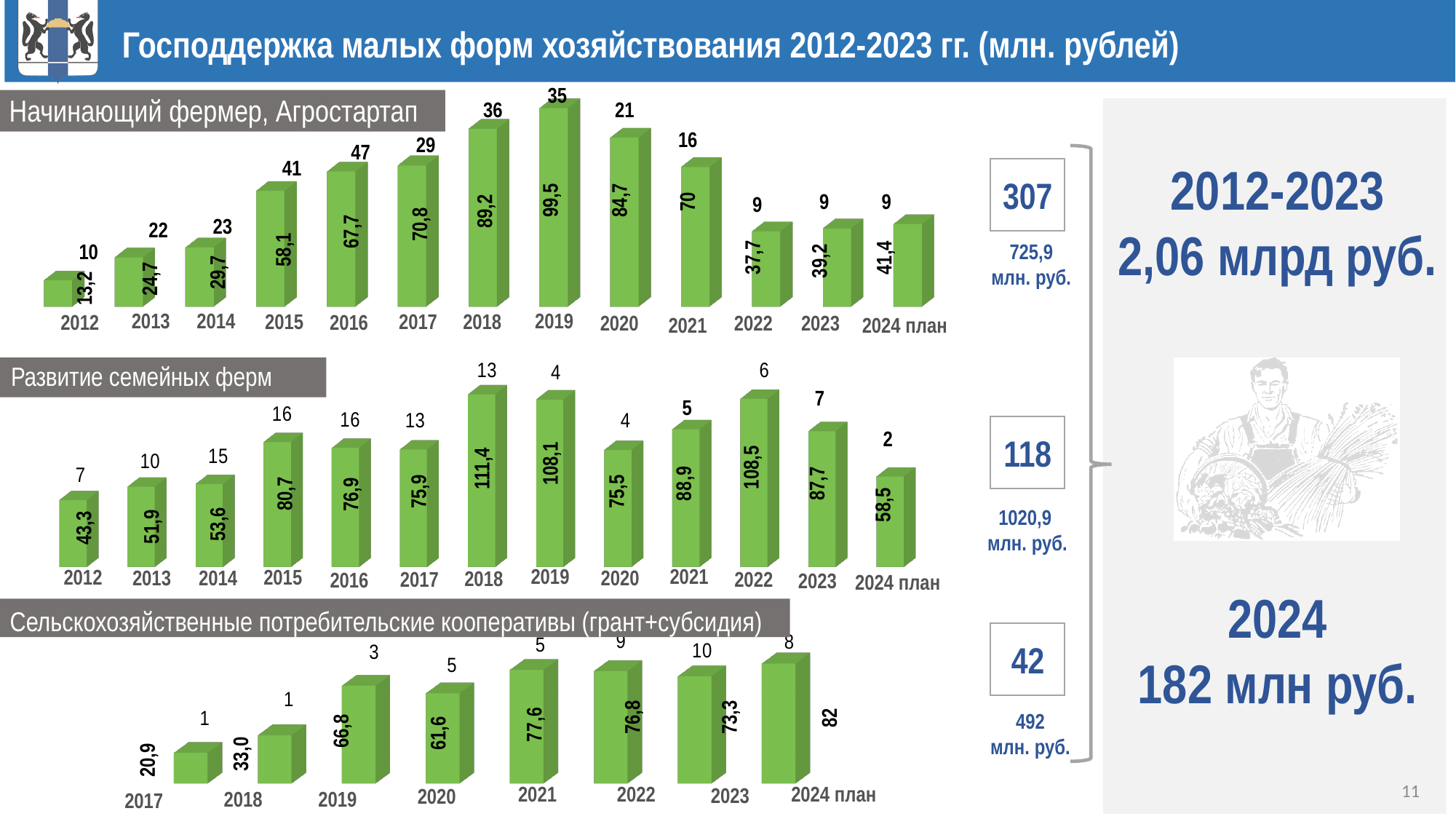
In the chart 'Развитие семейных ферм', what is the value for 2018? 111,4 In the chart 'Начинающий фермер, Агростартап', what is the value for 2019? 99,5 How many bars are in the chart 'Начинающий фермер, Агростартап'? 13 In the chart 'Развитие семейных ферм', what is the difference between the values for 2018 and 2012? 68,1 In the chart 'Сельскохозяйственные потребительские кооперативы (грант+субсидия)', what is the value for 2024 план? 82 In the chart 'Начинающий фермер, Агростартап', do the values rise or fall from 2012 to 2019? Rise What kind of chart is 'Развитие семейных ферм'? Bar chart In the chart 'Развитие семейных ферм', which year has the lowest value? 2012 In the chart 'Начинающий фермер, Агростартап', which year has the highest value? 2019 In the chart 'Сельскохозяйственные потребительские кооперативы (грант+субсидия)', which is larger, the value for 2021 or the value for 2023? 2021 How many bars are in the chart 'Сельскохозяйственные потребительские кооперативы (грант+субсидия)'? 8 In the chart 'Начинающий фермер, Агростартап', which year has the lowest value? 2012